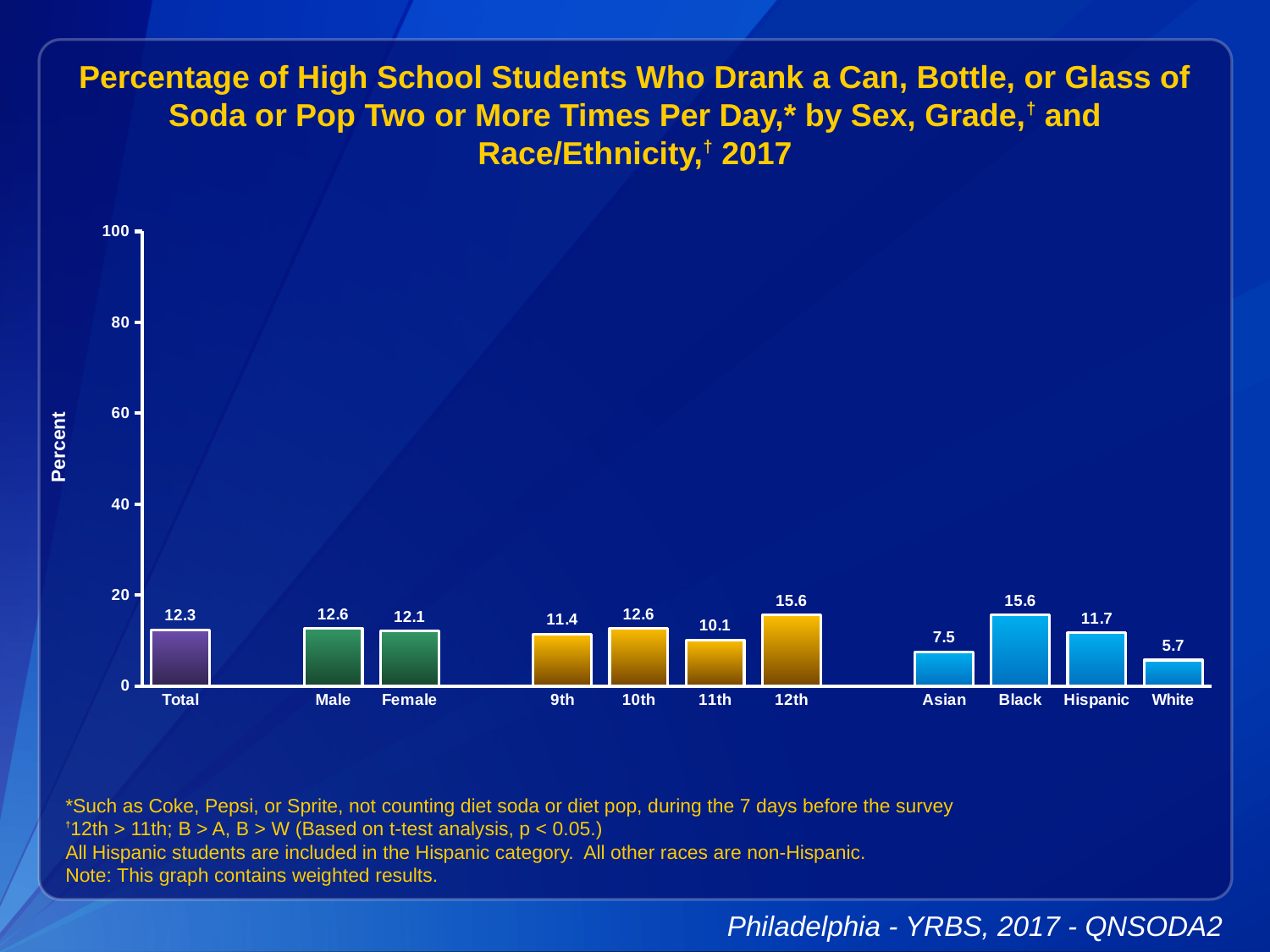
What is the value for 11th grade? 10.1 Which is larger, the value for Male or the value for Female? Male How many categories are shown on the x axis? 11 Is the value for Black students greater or less than 20? less What is the value for Female? 12.1 Which grade has the highest value? 12th What is the difference between the values for 12th grade and 11th grade? 5.5 What is the difference between the values for Black and White students? 9.9 What is the value for Total? 12.3 Which race/ethnicity category has the lowest value? White What kind of chart is shown on the slide? Bar chart What is the value for Asian students? 7.5